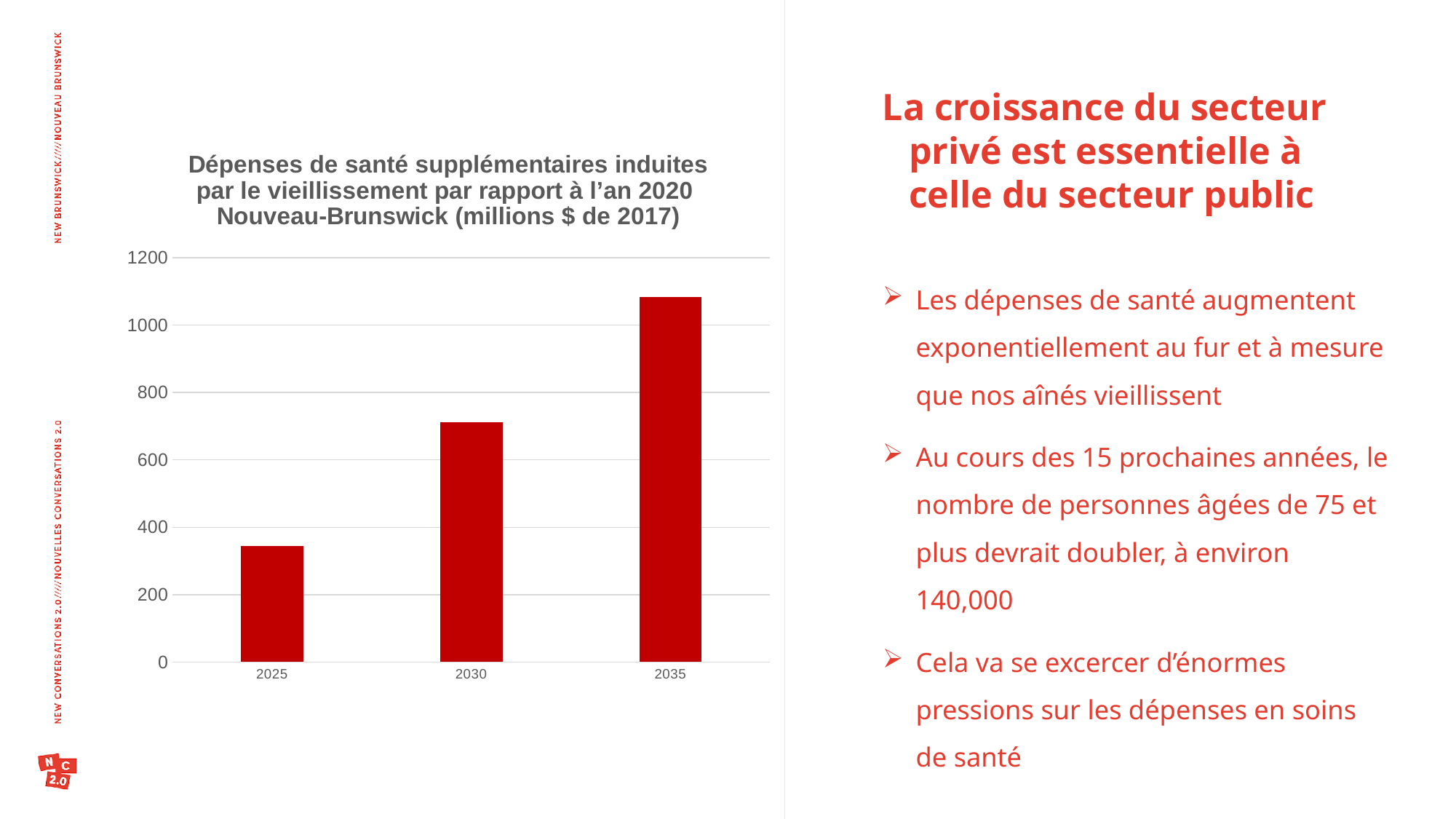
How many years (categories) are plotted on the chart? 3 Is the value for 2025 greater or less than 400? less Which year has the lowest additional health spending on the chart? 2025 Do the values rise or fall from 2025 to 2035? rise Is the value for 2025 greater or less than 200? greater What kind of chart is shown on the slide? bar chart What colour are the bars in the chart? red Is the value for 2030 greater or less than 600? greater Which year has the highest additional health spending on the chart? 2035 Which is larger, the value for 2030 or the value for 2035? 2035